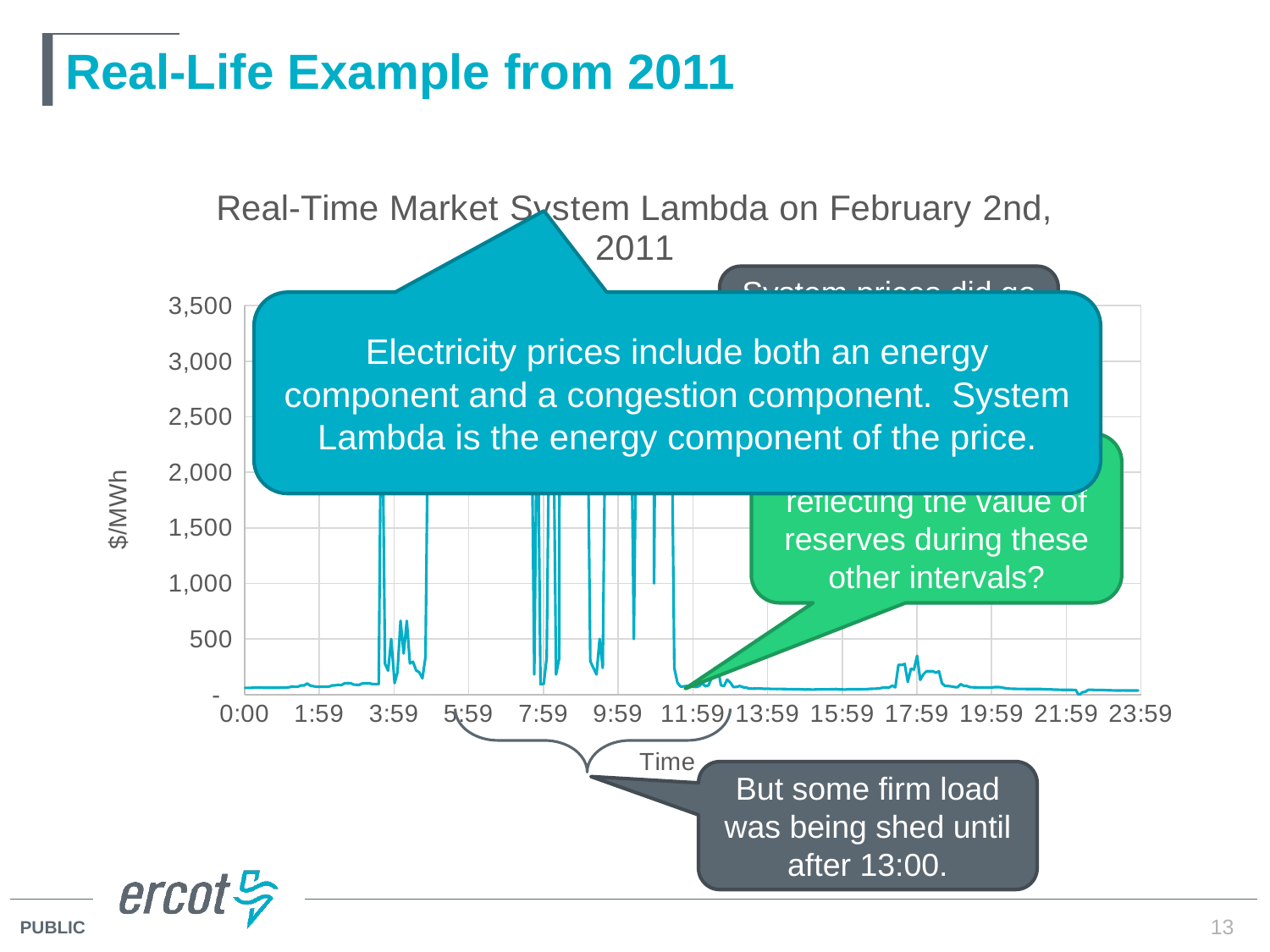
What kind of chart is shown on the slide? line chart Is the value at 15:59 greater or less than 500? less Which is larger, the value at 3:59 or the value at 15:59? 3:59 How many time labels are shown along the x-axis? 13 Is the value at 23:59 greater or less than 1,000? less Is the value at 21:59 greater or less than 500? less What is the title of the chart? Real-Time Market System Lambda on February 2nd, 2011 What is the highest value shown on the y-axis scale? 3,500 What unit is shown on the y-axis of the chart? $/MWh